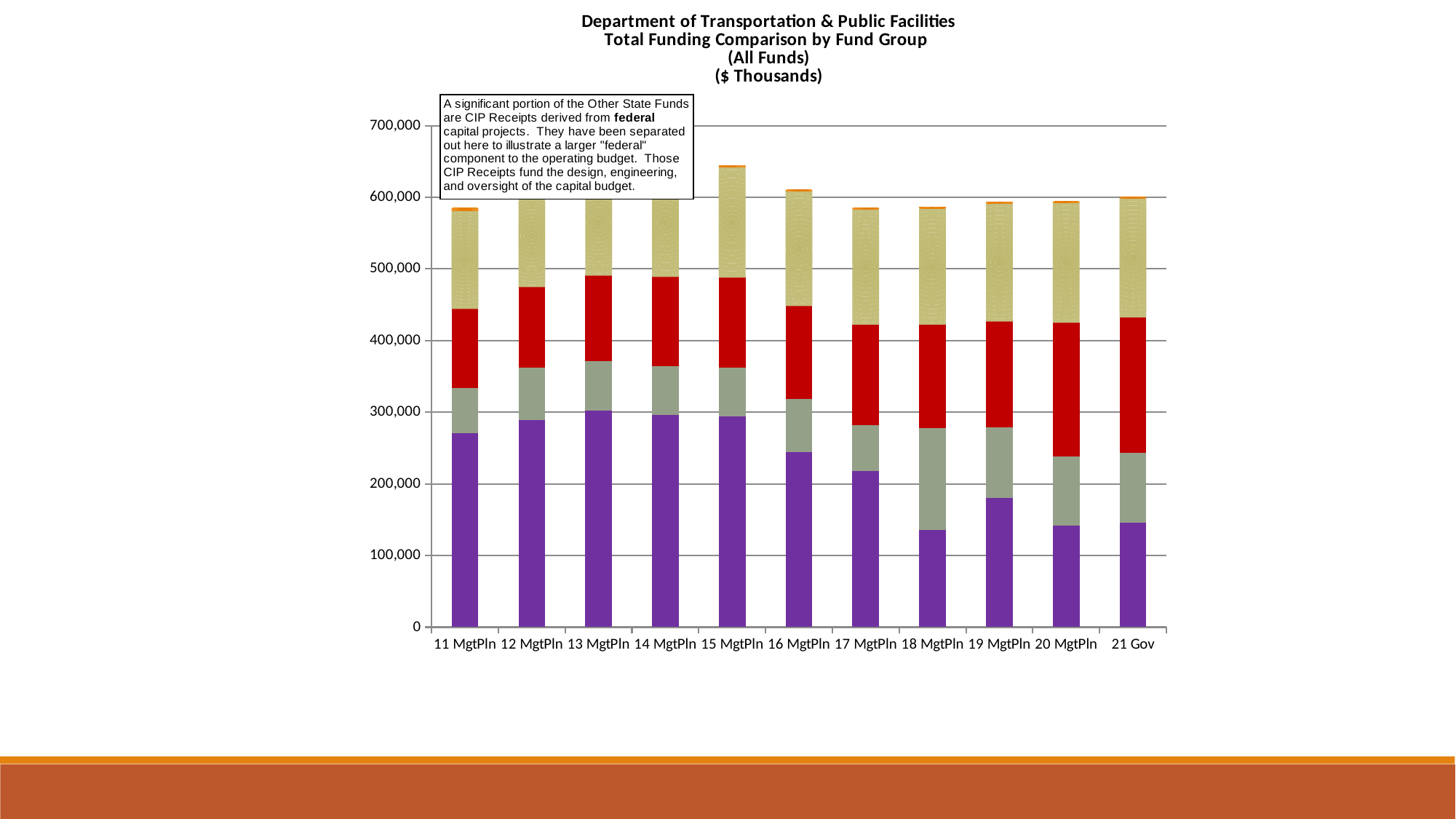
In what units are the values on the chart expressed, according to the title? $ Thousands Which category has the tallest total bar? 15 MgtPln Is the bottom (purple) segment for 11 MgtPln greater or less than 300,000? less Does the bottom (purple) segment rise or fall from 16 MgtPln to 18 MgtPln? fall How many categories (fiscal years) are shown along the x axis? 11 Is the total bar for 17 MgtPln greater or less than 600,000? less Is the bottom (purple) segment for 18 MgtPln greater or less than 200,000? less Which has the larger bottom (purple) segment, 13 MgtPln or 18 MgtPln? 13 MgtPln Which has the larger total bar, 15 MgtPln or 11 MgtPln? 15 MgtPln What kind of chart is shown on the slide? Stacked bar chart